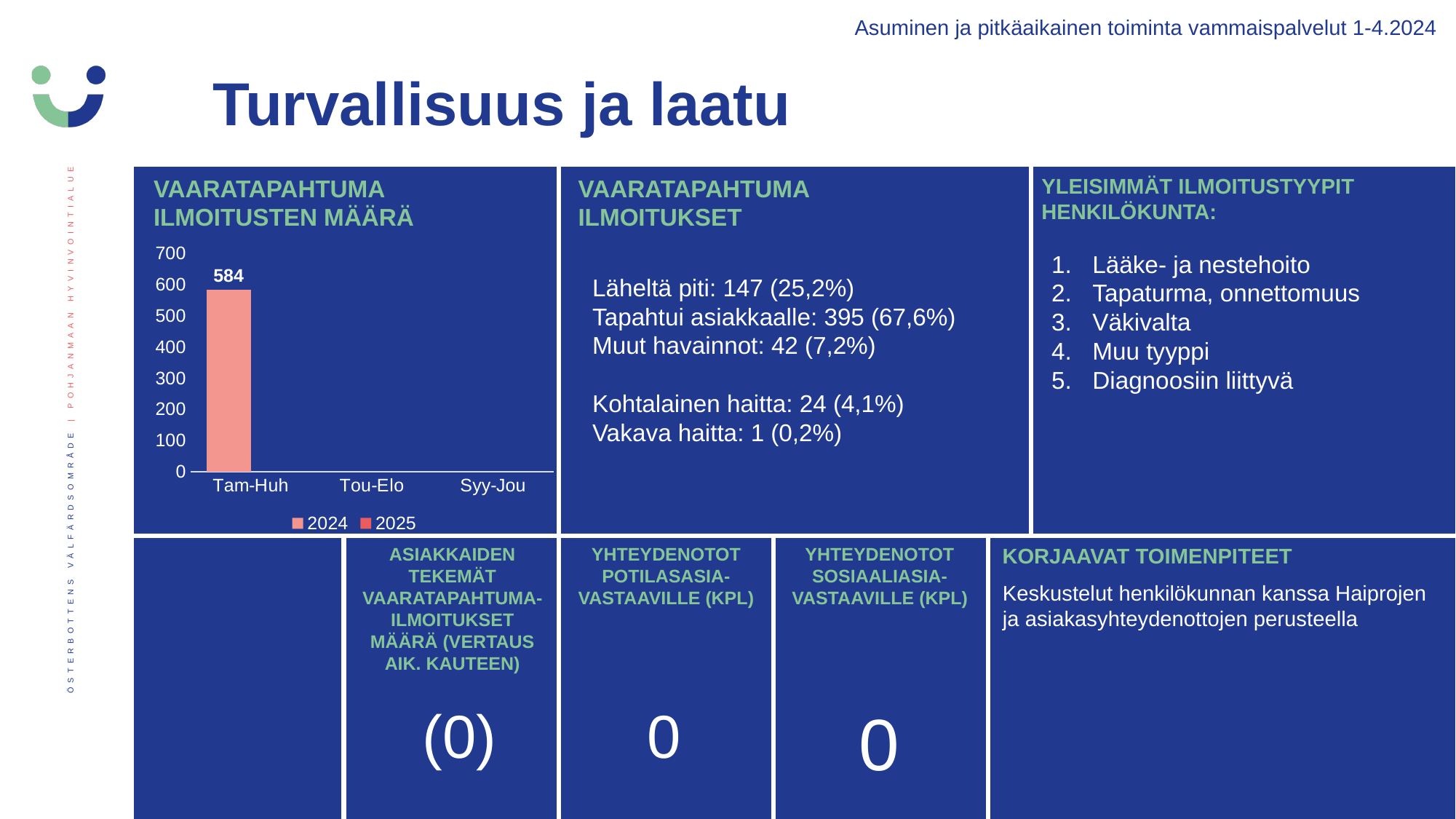
What is the value of the 2024 bar for Tam-Huh in the chart titled VAARATAPAHTUMA ILMOITUSTEN MÄÄRÄ? 584 Which category on the x axis of the VAARATAPAHTUMA ILMOITUSTEN MÄÄRÄ chart has a bar plotted? Tam-Huh Is the value for Tam-Huh in the VAARATAPAHTUMA ILMOITUSTEN MÄÄRÄ chart greater or less than 500? greater How many categories are shown on the x axis of the VAARATAPAHTUMA ILMOITUSTEN MÄÄRÄ chart? 3 What are the category labels on the x axis of the VAARATAPAHTUMA ILMOITUSTEN MÄÄRÄ chart? Tam-Huh, Tou-Elo, Syy-Jou Is the value for Tam-Huh in the VAARATAPAHTUMA ILMOITUSTEN MÄÄRÄ chart greater or less than 600? less What kind of chart is shown under the title VAARATAPAHTUMA ILMOITUSTEN MÄÄRÄ? bar chart Which series are listed in the legend of the VAARATAPAHTUMA ILMOITUSTEN MÄÄRÄ chart? 2024 and 2025 How many series does the legend of the VAARATAPAHTUMA ILMOITUSTEN MÄÄRÄ chart list? 2 What is the highest value shown on the y axis of the VAARATAPAHTUMA ILMOITUSTEN MÄÄRÄ chart? 700